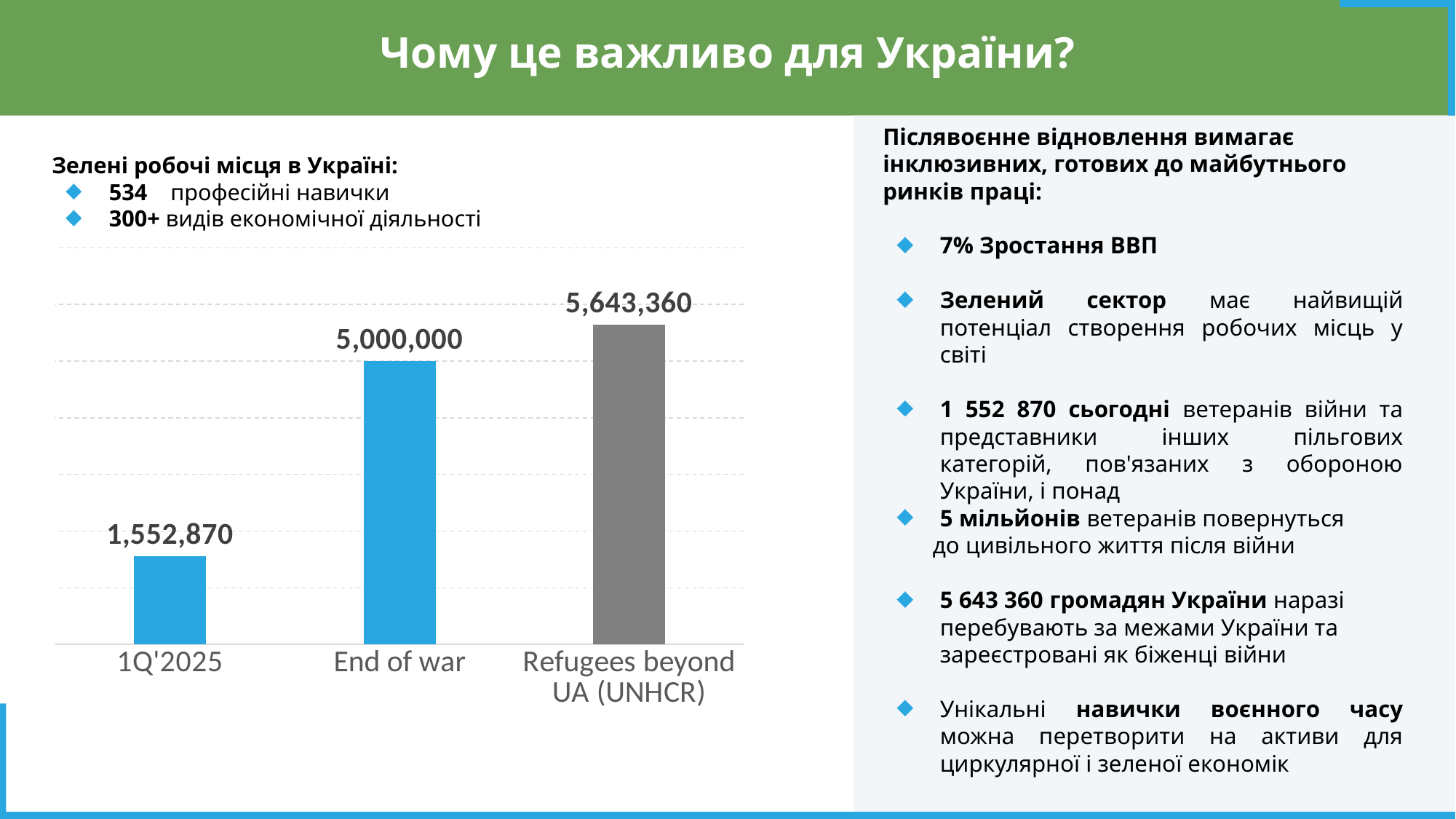
Which is larger, the value for End of war or the value for 1Q'2025? End of war What is the difference between the values for End of war and 1Q'2025? 3,447,130 What is the value shown for End of war? 5,000,000 Which category has the lowest value? 1Q'2025 How many categories are shown on the x axis of the chart? 3 What kind of chart is shown on the slide? Bar chart What is the value shown for Refugees beyond UA (UNHCR)? 5,643,360 Which category has the highest value? Refugees beyond UA (UNHCR) What is the value shown for 1Q'2025? 1,552,870 What colour is the bar for Refugees beyond UA (UNHCR)? Gray What is the difference between the values for Refugees beyond UA (UNHCR) and End of war? 643,360 Do the values rise or fall from left to right along the x axis? Rise